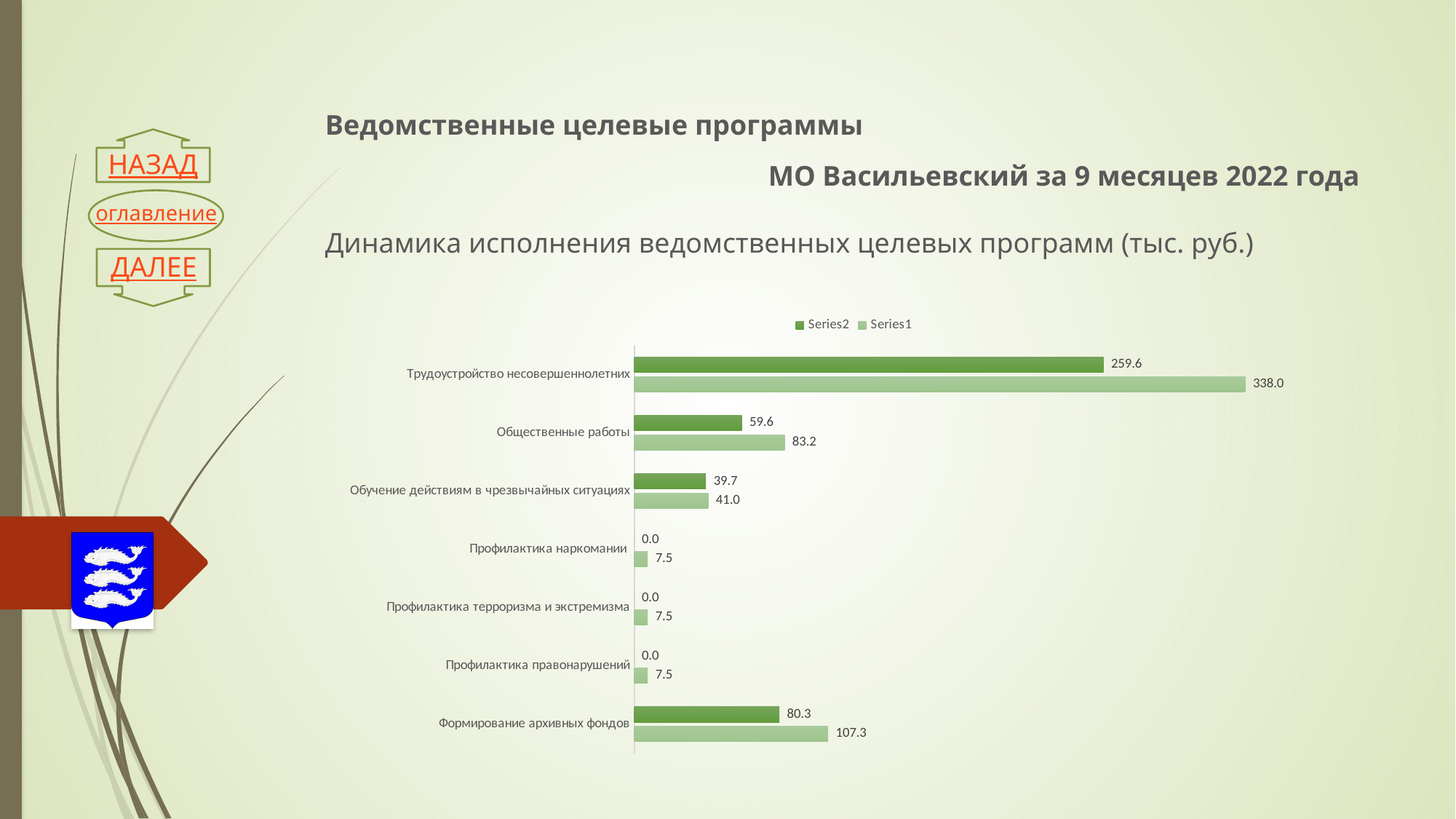
What is the difference between the Series1 and Series2 values for Трудоустройство несовершеннолетних? 78.4 What is the Series2 value for Общественные работы? 59.6 How many categories are shown in the chart? 7 What type of chart is shown on the slide? bar chart How many series does the chart legend list? 2 What is the Series1 value for Формирование архивных фондов? 107.3 What is the Series1 value for Трудоустройство несовершеннолетних? 338.0 Which category has the highest Series1 value? Трудоустройство несовершеннолетних Which series is shown in dark green in the legend? Series2 Which is larger: the Series2 value for Формирование архивных фондов or the Series2 value for Общественные работы? Формирование архивных фондов Which category has the lowest Series1 value among those with a non-zero Series2 value? Обучение действиям в чрезвычайных ситуациях What is the Series2 value for Профилактика наркомании? 0.0